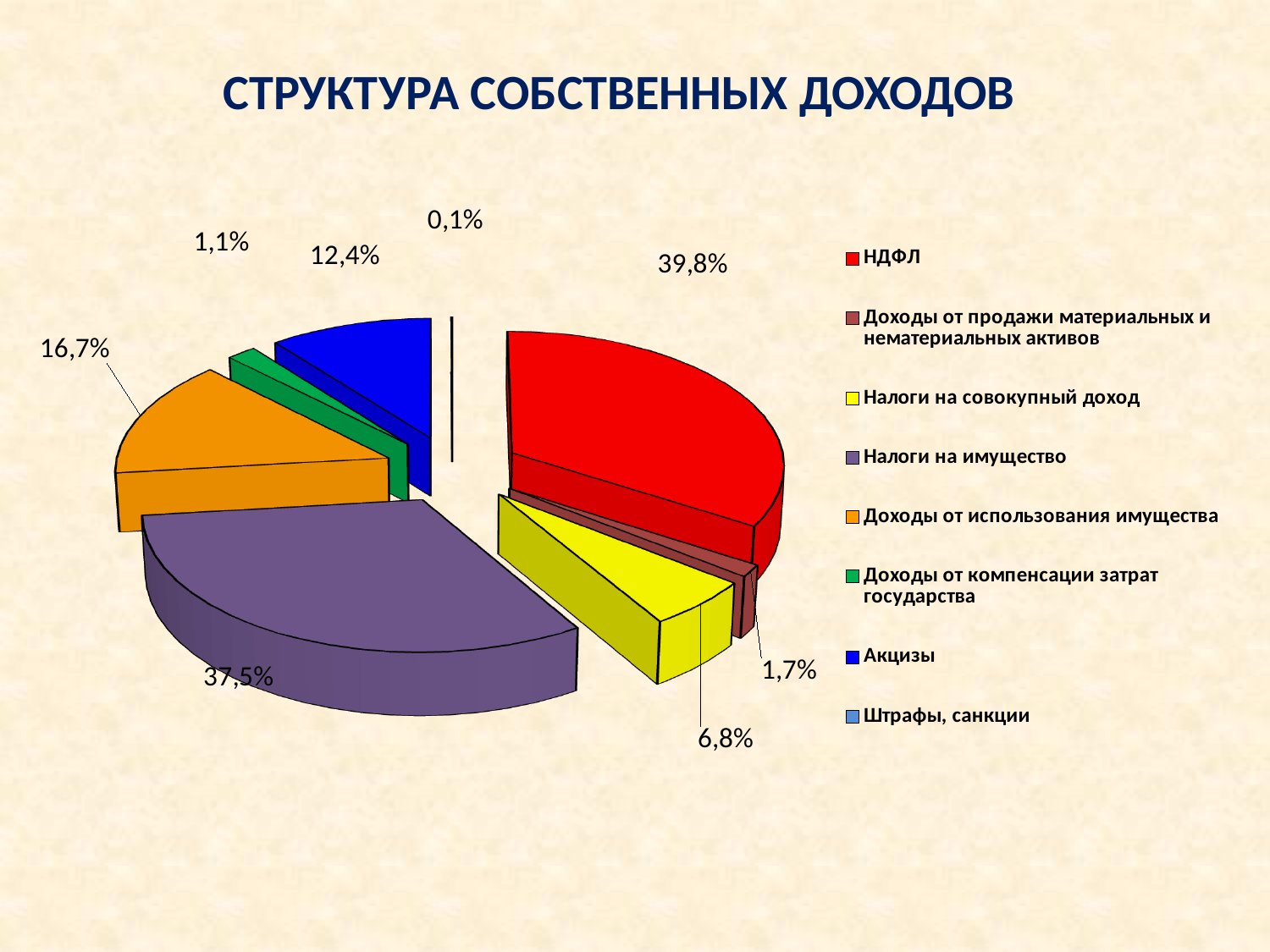
What percentage is shown for НДФЛ? 39,8% What percentage is shown for Налоги на совокупный доход? 6,8% What percentage is shown for Налоги на имущество? 37,5% Which category has the largest share of the pie? НДФЛ How many categories does the legend list? 8 What is the difference between the shares of Доходы от использования имущества and Акцизы? 4,3% What kind of chart is shown on the slide? pie chart Which category has the smallest share of the pie? Штрафы, санкции What percentage is shown for Акцизы? 12,4% What percentage is shown for Штрафы, санкции? 0,1% What percentage is shown for Доходы от использования имущества? 16,7% What is the title of the chart? СТРУКТУРА СОБСТВЕННЫХ ДОХОДОВ